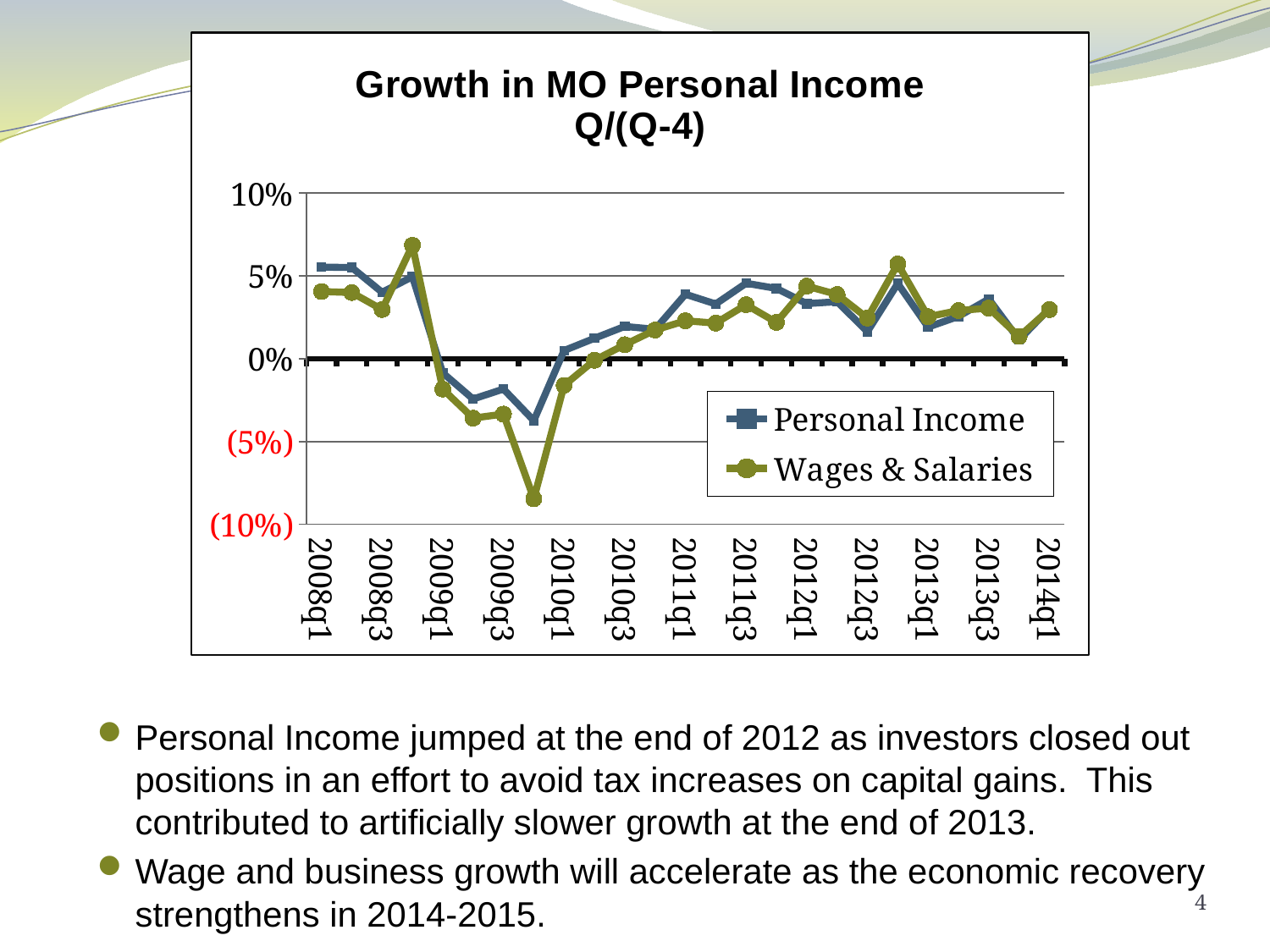
Is the value of Personal Income at 2009q3 greater or less than 0%? less Is the lowest value of the Wages & Salaries series greater or less than (5%)? less How many quarter labels are printed along the x axis? 13 In which year does the Wages & Salaries series reach its lowest value? 2009 What kind of chart is shown on the slide? line chart At 2011q1, which series has the higher value, Personal Income or Wages & Salaries? Personal Income Does the Personal Income series rise or fall between 2008q1 and 2009q3? fall How many series does the legend list? 2 What are the two series named in the legend? Personal Income and Wages & Salaries What is the title of the chart? Growth in MO Personal Income Q/(Q-4) At 2008q1, which series has the higher value, Personal Income or Wages & Salaries? Personal Income Is the value of Wages & Salaries at 2014q1 greater or less than 0%? greater